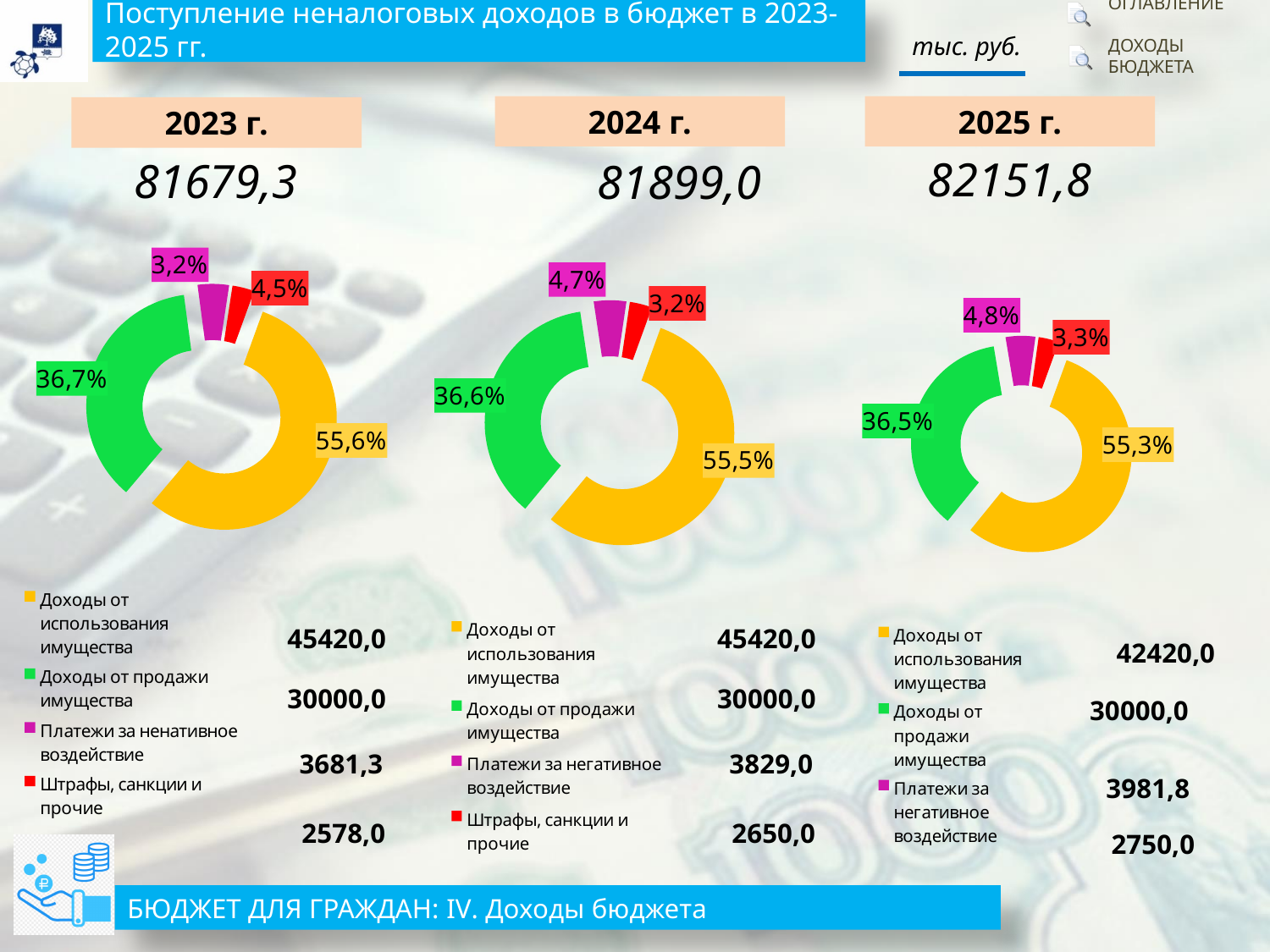
In the 2023 г. chart, which category has the smallest value? Штрафы, санкции и прочие How many slices does the 2023 г. pie chart have? 4 In the 2025 г. chart, what is the value for Платежи за негативное воздействие? 3981,8 What kind of chart is used for each year on the slide? Pie (donut) chart In the 2024 г. chart, what is the value for Штрафы, санкции и прочие? 2650,0 In the 2024 г. chart, which is larger: Платежи за негативное воздействие or Штрафы, санкции и прочие? Платежи за негативное воздействие Do the total non-tax revenues shown above the charts rise or fall from 2023 г. to 2025 г.? Rise In the 2025 г. chart, what is the difference between Доходы от использования имущества and Доходы от продажи имущества? 12420,0 In the 2023 г. chart, what share of the pie is Доходы от использования имущества? 55,6% In the 2023 г. chart, which category has the largest value? Доходы от использования имущества In the 2025 г. chart, what share of the pie is Доходы от использования имущества? 55,3% In the 2024 г. chart, what share of the pie is Доходы от продажи имущества? 36,6%